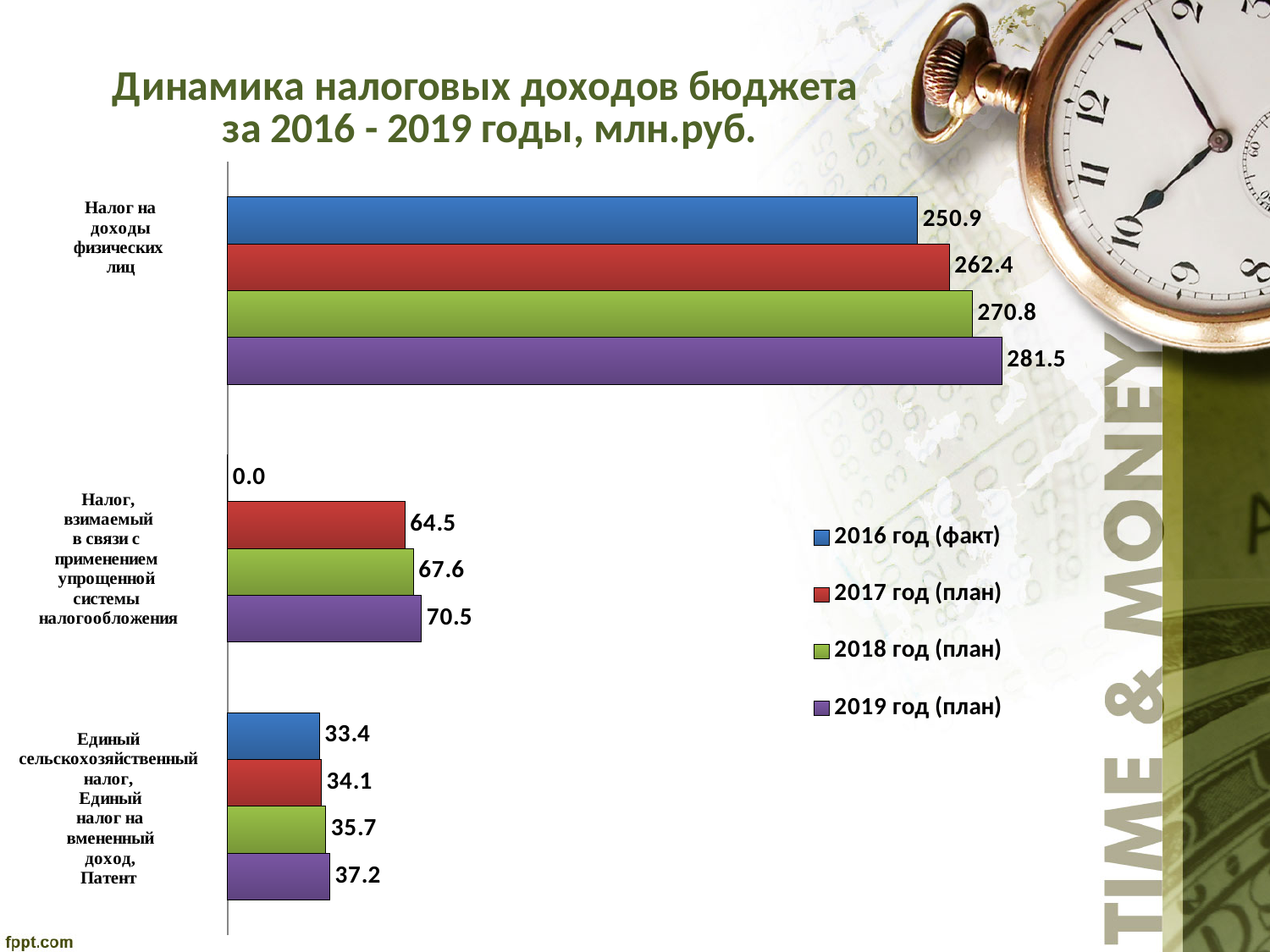
What kind of chart is shown on the slide? Bar chart What is the 2016 год (факт) value for the Налог, взимаемый в связи с применением упрощенной системы налогообложения category? 0.0 How many categories are shown on the chart? 3 What is the 2018 год (план) value for the Единый сельскохозяйственный налог, Единый налог на вмененный доход, Патент category? 35.7 Which is larger for Единый сельскохозяйственный налог, Единый налог на вмененный доход, Патент: the 2018 год (план) value or the 2019 год (план) value? 2019 год (план) What is the value for Налог на доходы физических лиц in the 2019 год (план) series? 281.5 What is the value for Налог на доходы физических лиц in the 2016 год (факт) series? 250.9 Which category has the lowest value in the 2017 год (план) series? Единый сельскохозяйственный налог, Единый налог на вмененный доход, Патент How many series does the legend list? 4 What is the difference between the 2019 год (план) and 2016 год (факт) values for Налог на доходы физических лиц? 30.6 Which category has the highest value in the 2019 год (план) series? Налог на доходы физических лиц What is the 2017 год (план) value for the Налог, взимаемый в связи с применением упрощенной системы налогообложения category? 64.5